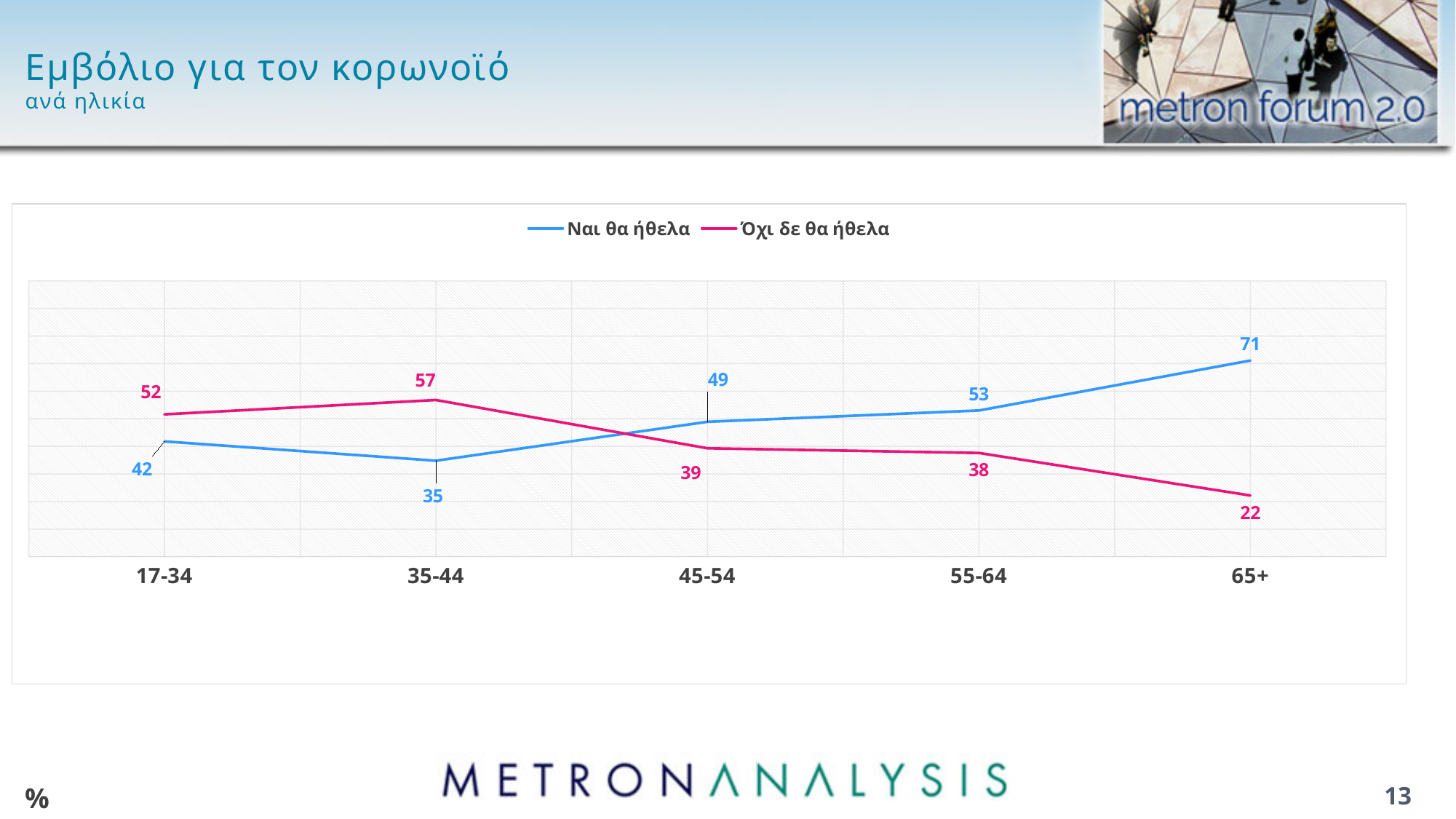
What is the difference between 'Ναι θα ήθελα' and 'Όχι δε θα ήθελα' for the 65+ age group? 49 Does the 'Όχι δε θα ήθελα' line rise or fall from the 35-44 group to the 65+ group? Fall Which age group has the highest value for 'Ναι θα ήθελα'? 65+ What is the value of 'Ναι θα ήθελα' for the 17-34 age group? 42 Which age group has the lowest value for 'Ναι θα ήθελα'? 35-44 For the 45-54 age group, which is larger: 'Ναι θα ήθελα' or 'Όχι δε θα ήθελα'? Ναι θα ήθελα How many series does the legend list? 2 Which age group has the lowest value for 'Όχι δε θα ήθελα'? 65+ What kind of chart is shown on the slide? Line chart What is the value of 'Όχι δε θα ήθελα' for the 35-44 age group? 57 How many age groups are shown on the x axis? 5 What is the value of 'Ναι θα ήθελα' for the 65+ age group? 71